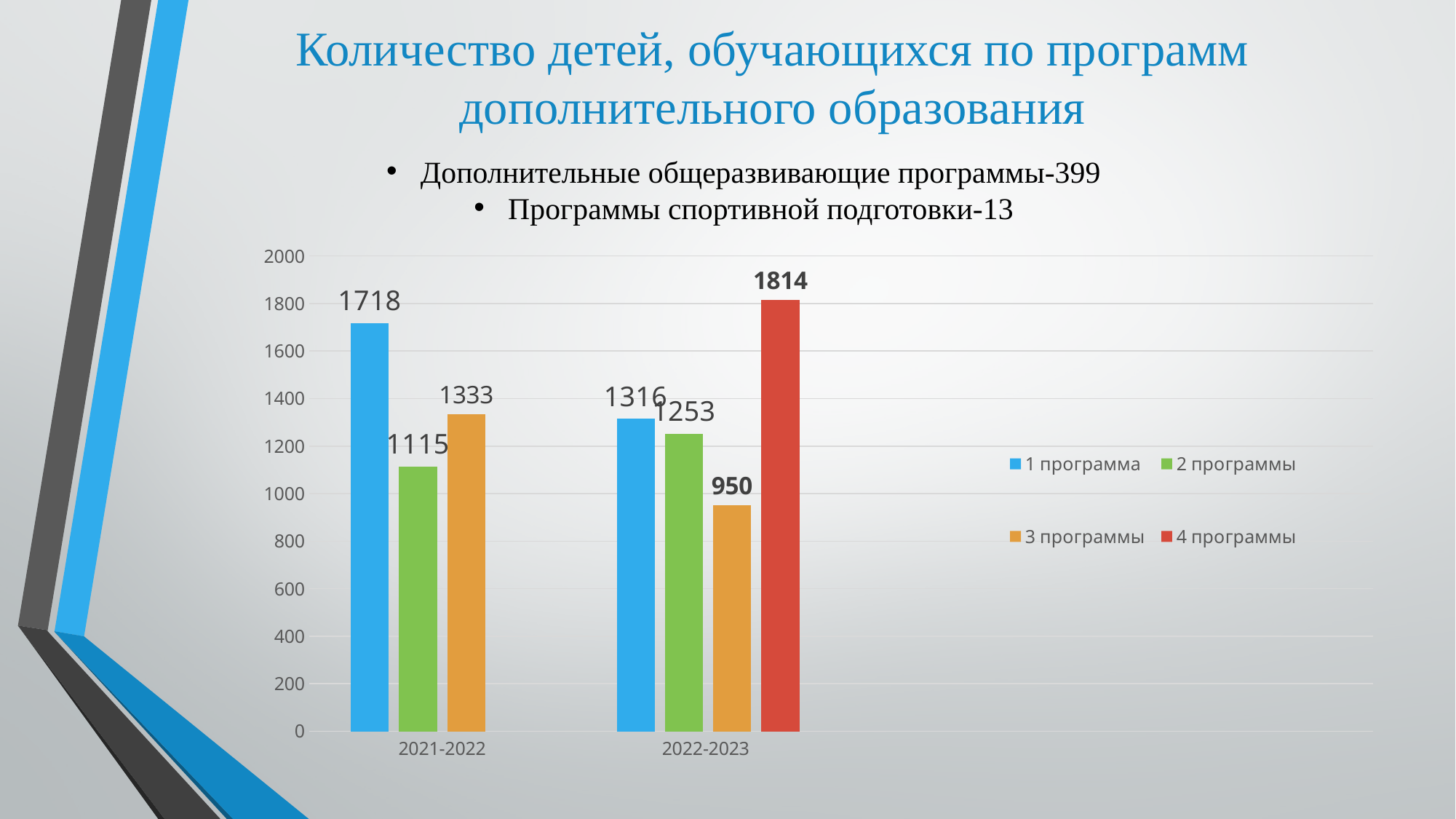
How many categories are shown on the x axis? 2 Which series has the lowest value in 2021-2022? 2 программы Which is larger: "2 программы" in 2021-2022 or "2 программы" in 2022-2023? 2022-2023 What is the value for "3 программы" in 2022-2023? 950 How many series does the legend list? 4 Which series has the highest value in 2022-2023? 4 программы What is the value for "1 программа" in 2021-2022? 1718 Which series is shown in red in the legend? 4 программы What is the difference between the "1 программа" values for 2021-2022 and 2022-2023? 402 What is the value for "4 программы" in 2022-2023? 1814 What is the value for "2 программы" in 2021-2022? 1115 What kind of chart is shown on the slide? Bar chart